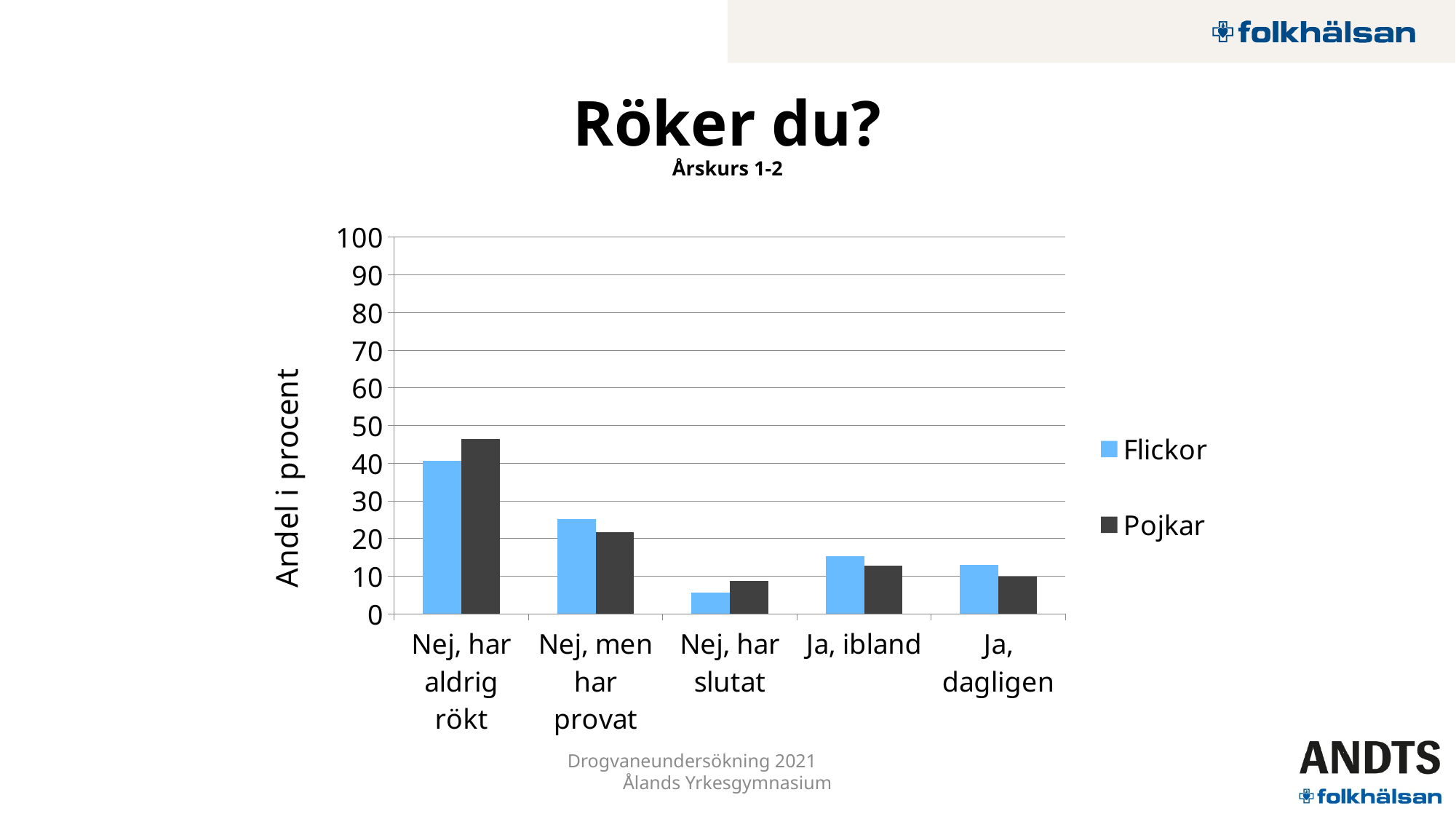
Which category has the lowest value for Pojkar? Nej, har slutat How many series does the legend list? 2 For 'Nej, har aldrig rökt', which series has the larger value, Flickor or Pojkar? Pojkar What is the title of the chart? Röker du? Is the value for Pojkar in 'Nej, har aldrig rökt' greater or less than 40? greater Is the value for Flickor in 'Ja, dagligen' greater or less than 20? less For 'Nej, har slutat', which series has the larger value, Flickor or Pojkar? Pojkar Which category has the lowest value for Flickor? Nej, har slutat Which category has the highest value for Flickor? Nej, har aldrig rökt What kind of chart is shown on the slide? bar chart How many response categories are shown on the x axis? 5 What is the label of the vertical axis? Andel i procent